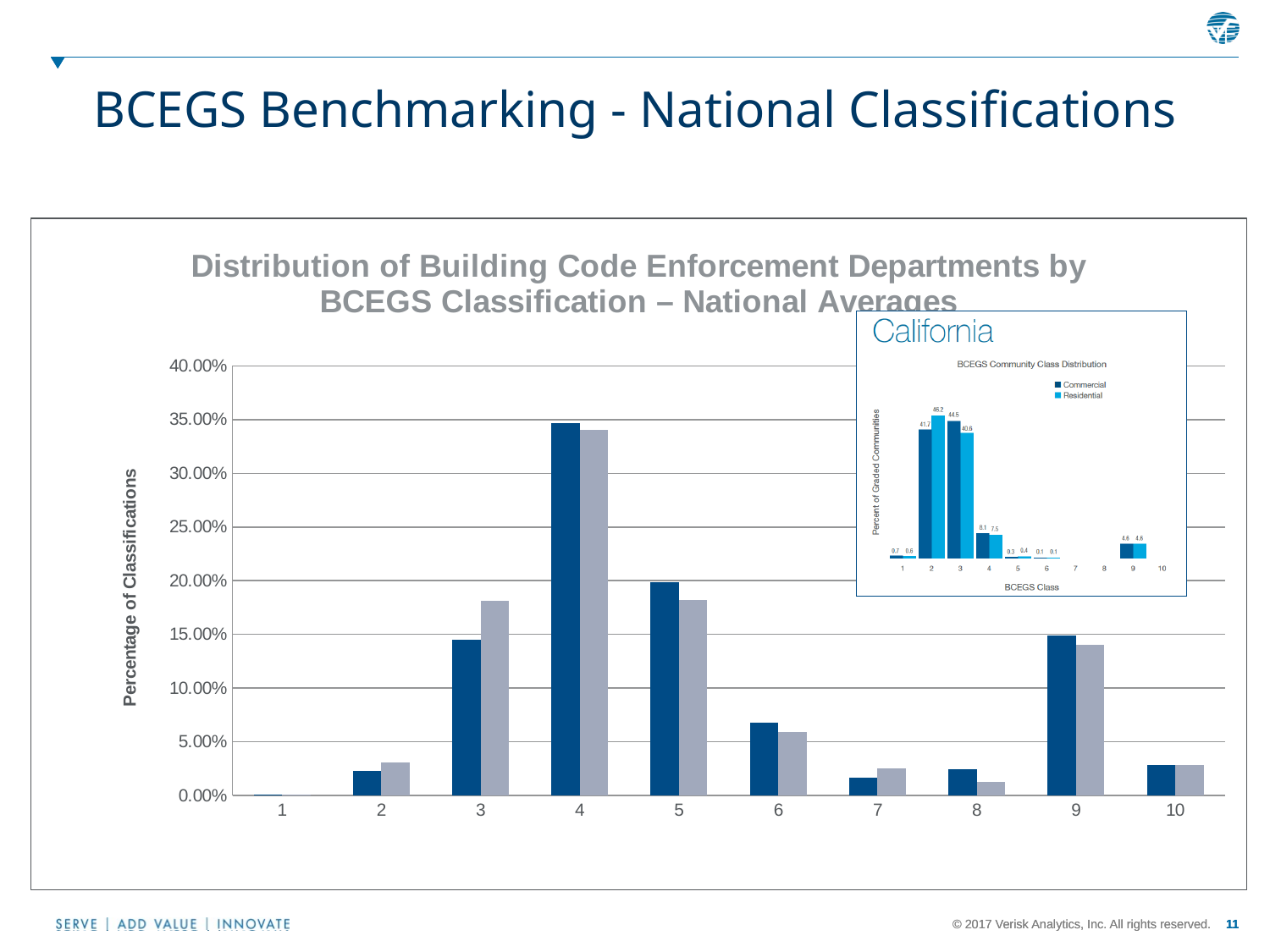
In the inset California chart, what is the Residential value for BCEGS class 2? 46.2 In the main national averages chart, which is larger for class 3: the dark blue bar or the grey bar? The grey bar In the main national averages chart, which BCEGS class has the highest bars? 4 In the main national averages chart, is the dark blue bar for class 4 greater or less than 30.00%? greater In the inset California chart, what is the difference between the Residential and Commercial values for BCEGS class 2? 4.5 What kind of chart is the main chart titled "Distribution of Building Code Enforcement Departments by BCEGS Classification – National Averages"? Bar chart In the main national averages chart, is the dark blue bar for class 2 greater or less than 5.00%? less In the main national averages chart, how many BCEGS classes are shown on the x axis? 10 In the inset California chart, how many series does the legend list? 2 In the inset California chart, what is the Commercial value for BCEGS class 3? 44.5 In the main national averages chart, which BCEGS class has the lowest bars? 1 In the main national averages chart, is the grey bar for class 3 greater or less than 15.00%? greater